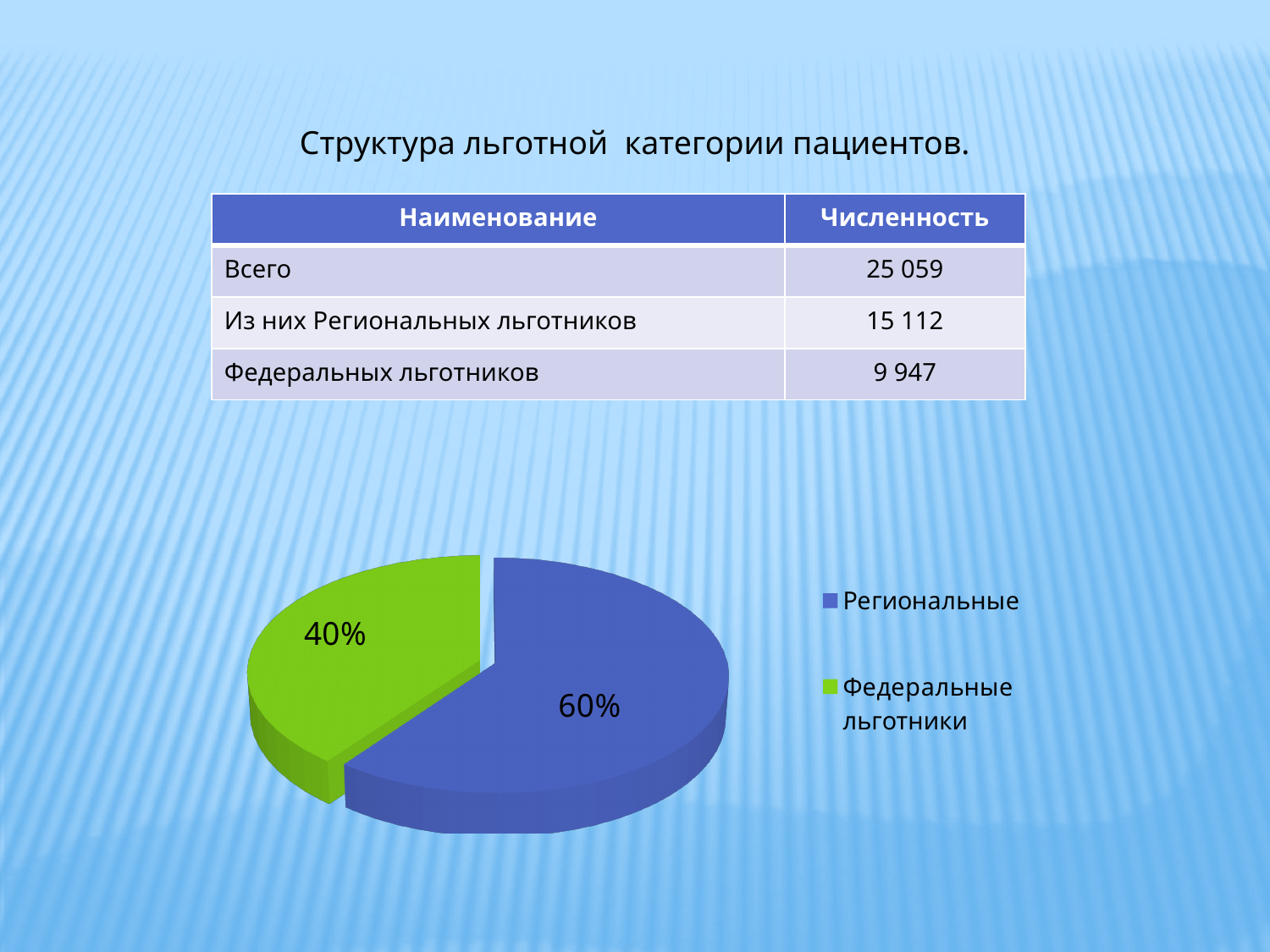
Which is larger, the Региональные slice or the Федеральные льготники slice? Региональные What kind of chart is shown on the slide? pie chart What colour is the Региональные slice? blue Which slice of the pie is the smallest? Федеральные льготники What colour is the Федеральные льготники slice? green What share of the pie does Региональные have? 60% What is the difference in percentage points between the Региональные slice and the Федеральные льготники slice? 20% What share of the pie does Федеральные льготники have? 40% How many slices does the pie chart have? 2 Which slice of the pie is the largest? Региональные How many entries does the legend list? 2